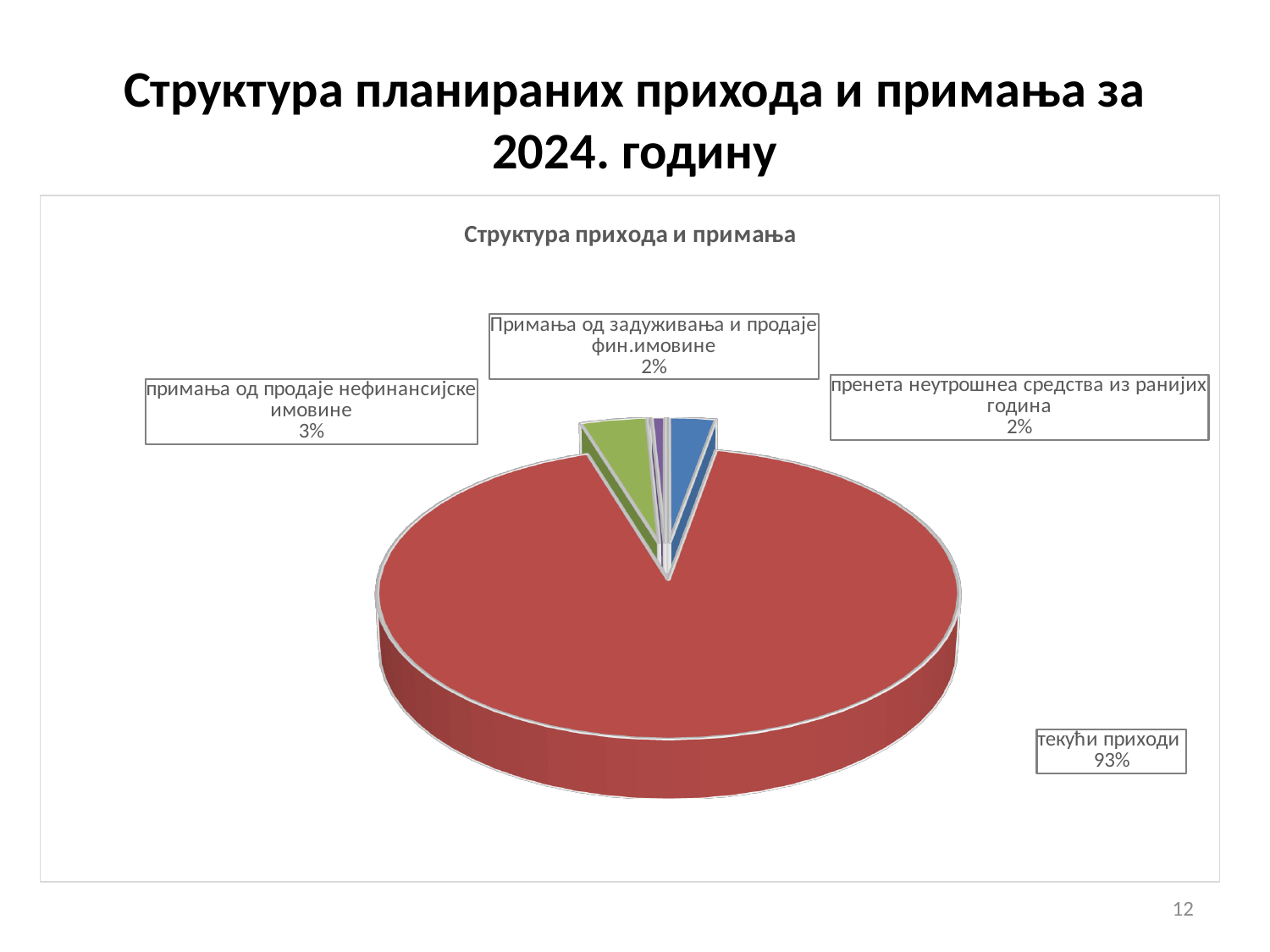
What share of the pie is labelled "текући приходи"? 93% What is the difference in percentage points between "текући приходи" and "примања од продаје нефинансијске имовине"? 90 What kind of chart is shown on the slide? pie chart What share of the pie is labelled "пренета неутрошнеа средства из ранијих година"? 2% What share of the pie is labelled "Примања од задуживања и продаје фин.имовине"? 2% Which category has the largest slice of the pie? текући приходи What is the combined share of the three smallest slices? 7% How many slices does the pie chart have? 4 What is the title of the chart? Структура прихода и примања What colour is the slice for "текући приходи"? red Which is larger: the slice for "примања од продаје нефинансијске имовине" or the slice for "пренета неутрошнеа средства из ранијих година"? примања од продаје нефинансијске имовине